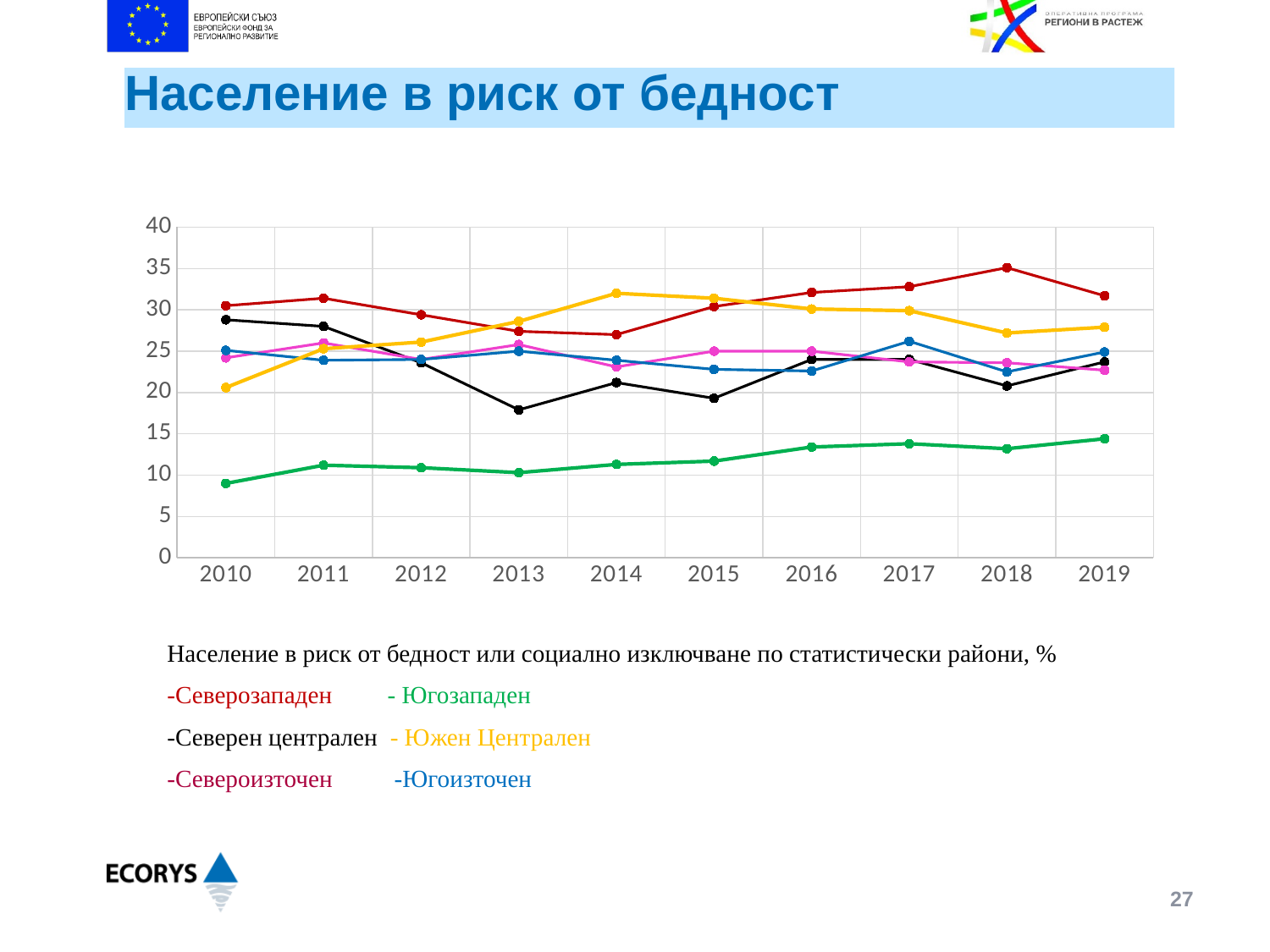
Is the value for Северен централен in 2013 greater or less than 20? less How many regions (series) are listed in the legend below the chart? 6 Which region has the lowest value in every year shown? Югозападен In which year does Северозападен reach its highest value? 2018 In 2014, which is larger: the value for Южен Централен or the value for Северозападен? Южен Централен How many years are plotted along the x axis of the chart? 10 Is the value for Северозападен in 2018 greater or less than 30? greater Is the value for Южен Централен in 2010 greater or less than 25? less Does the line for Югозападен generally rise or fall from 2010 to 2019? rise Which region has the highest value in 2019? Северозападен What kind of chart is shown on the slide? line chart